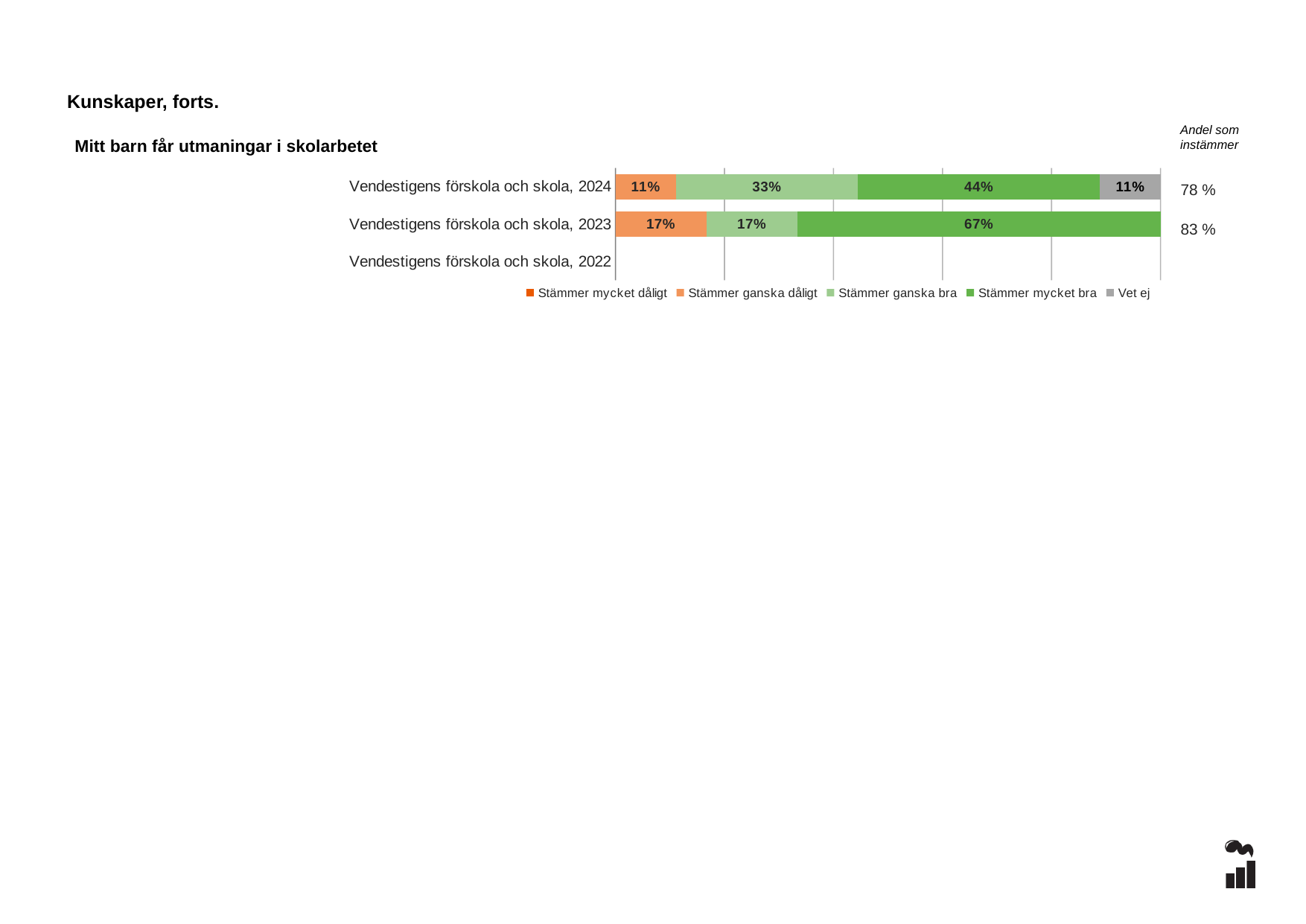
What is the value for "Stämmer mycket bra" for Vendestigens förskola och skola, 2024? 44% Which category has no data plotted in the chart? Vendestigens förskola och skola, 2022 Which year has the larger "Stämmer mycket bra" share, 2024 or 2023? 2023 What is the title of the chart? Mitt barn får utmaningar i skolarbetet What is the value for "Stämmer mycket bra" for Vendestigens förskola och skola, 2023? 67% What is the value for "Vet ej" for Vendestigens förskola och skola, 2024? 11% What kind of chart is shown on the slide? Stacked bar chart What is the value for "Stämmer ganska dåligt" for Vendestigens förskola och skola, 2023? 17% What is the "Andel som instämmer" value shown for Vendestigens förskola och skola, 2024? 78 % How many series does the legend list? 5 How many categories are listed on the vertical axis of the chart? 3 What is the difference between the "Stämmer ganska bra" values for 2024 and 2023? 16%